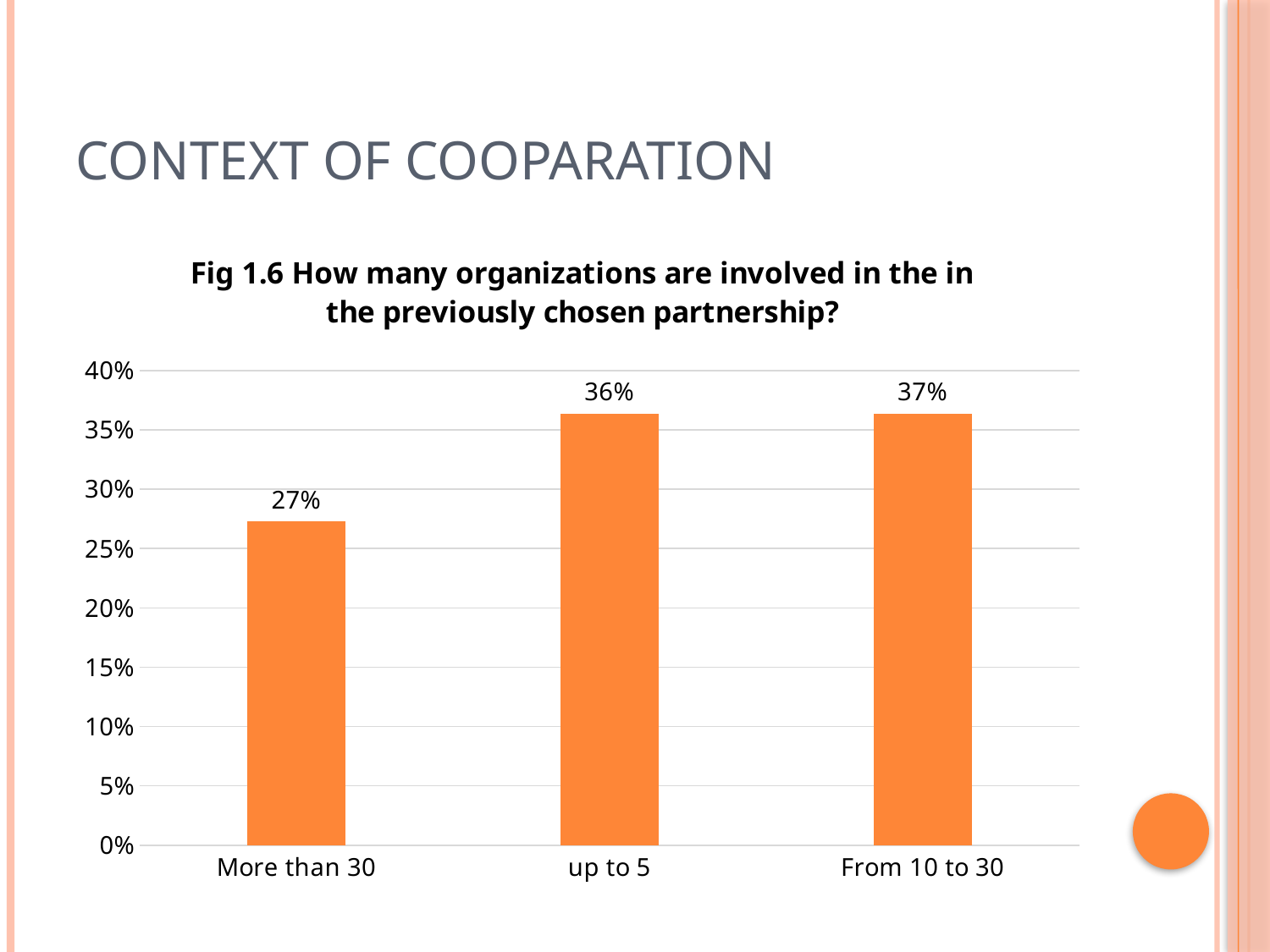
Which category has the highest value? From 10 to 30 What is the value for "up to 5"? 36% What is the value for "More than 30"? 27% What kind of chart is shown on the slide? bar chart What is the title of the chart? Fig 1.6 How many organizations are involved in the in the previously chosen partnership? How many categories are shown on the x axis? 3 What is the value for "From 10 to 30"? 37% Do the values rise or fall from left to right along the x axis? rise Which is larger, the value for "up to 5" or the value for "More than 30"? up to 5 Is the value for "More than 30" greater or less than 30%? less Which category has the lowest value? More than 30 What is the difference between the values for "From 10 to 30" and "More than 30"? 10%